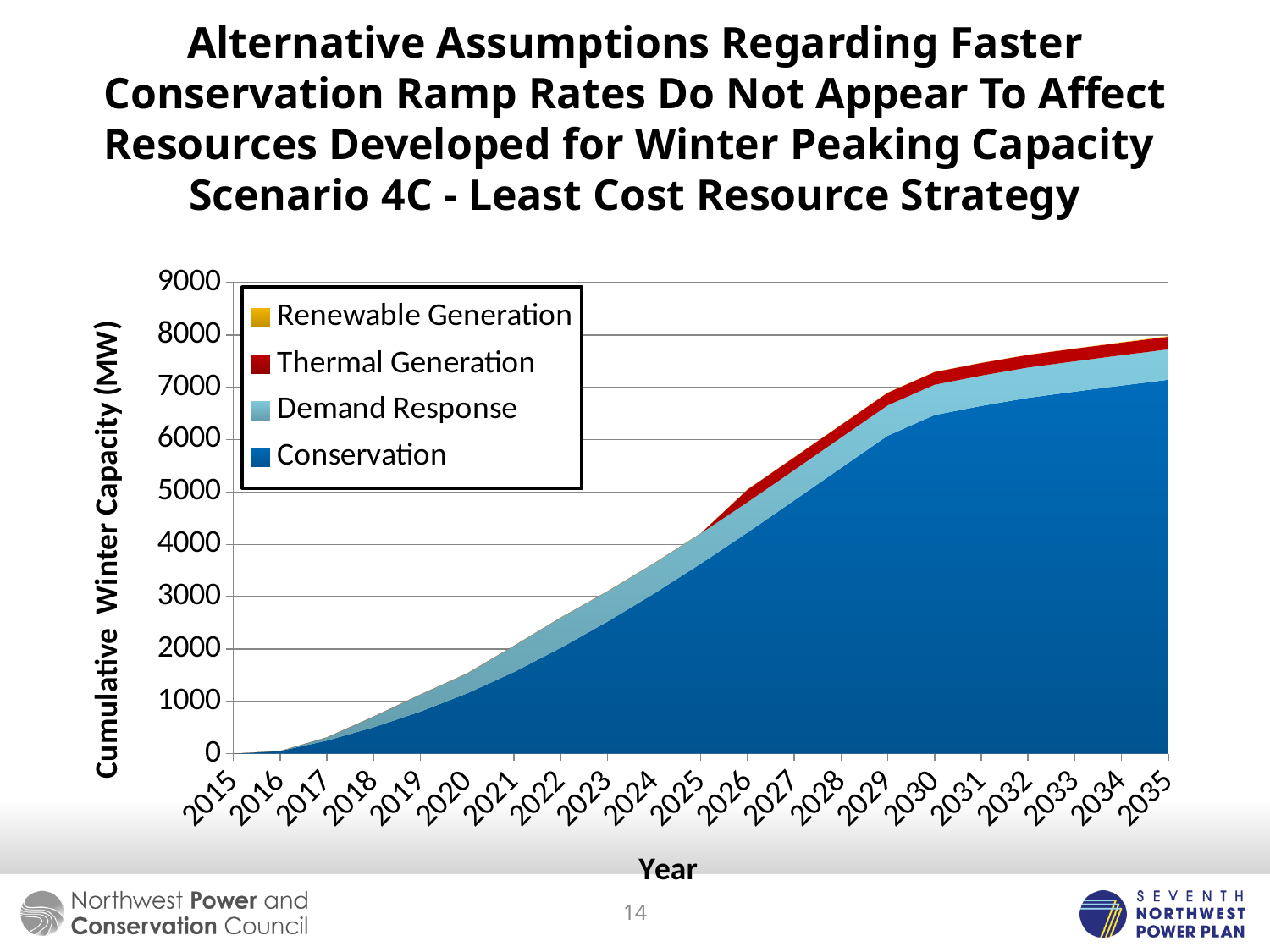
Which series contributes the largest share of cumulative winter capacity in 2035? Conservation How many years are shown along the x axis? 21 Is the total cumulative winter capacity in 2020 greater or less than 2000 MW? less Is the total cumulative winter capacity in 2028 greater or less than 5000 MW? greater In which year is the total cumulative winter capacity highest? 2035 Is the total cumulative winter capacity in 2035 greater or less than 7000 MW? greater What is the label of the y axis? Cumulative Winter Capacity (MW) How many series does the legend list? 4 Does the total cumulative winter capacity rise or fall from 2015 to 2035? Rises Which series is shown in red? Thermal Generation What kind of chart is shown on the slide? Stacked area chart In which year is the total cumulative winter capacity lowest? 2015